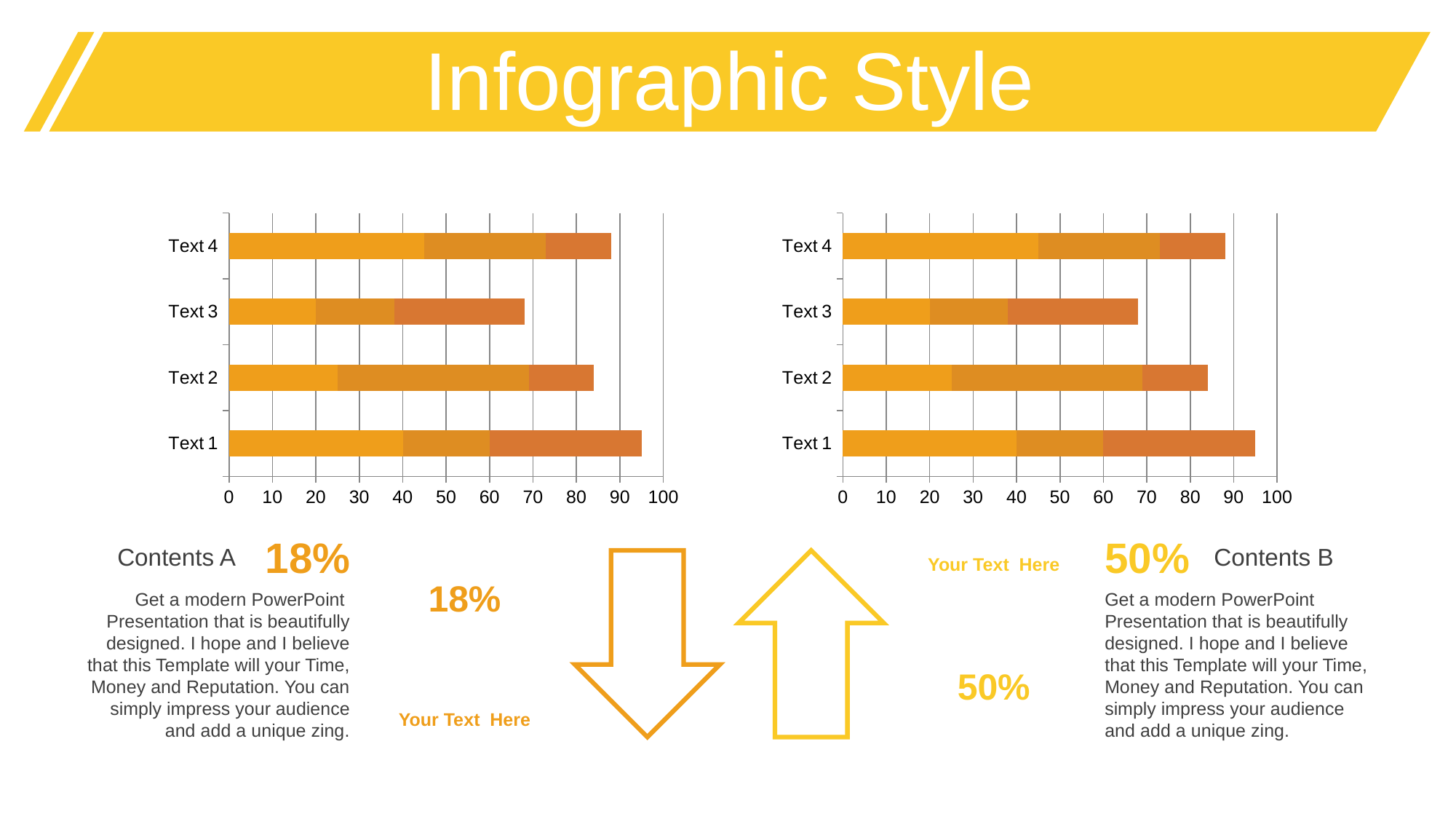
On the left chart, which category has the shortest bar? Text 3 On the right chart, is the total bar length for Text 4 greater or less than 80? greater On the left chart, which category has the longest bar? Text 1 On the right chart, which category has the longest bar? Text 1 On the right chart, which category has the shortest bar? Text 3 On the left chart, how many categories are plotted? 4 On the right chart, which bar is longer, Text 2 or Text 3? Text 2 On the left chart, is the total bar length for Text 3 greater or less than 60? greater On the left chart, is the total bar length for Text 1 greater or less than 90? greater What is the highest value shown on the x axis of the right chart? 100 On the left chart, what kind of chart is shown? bar chart